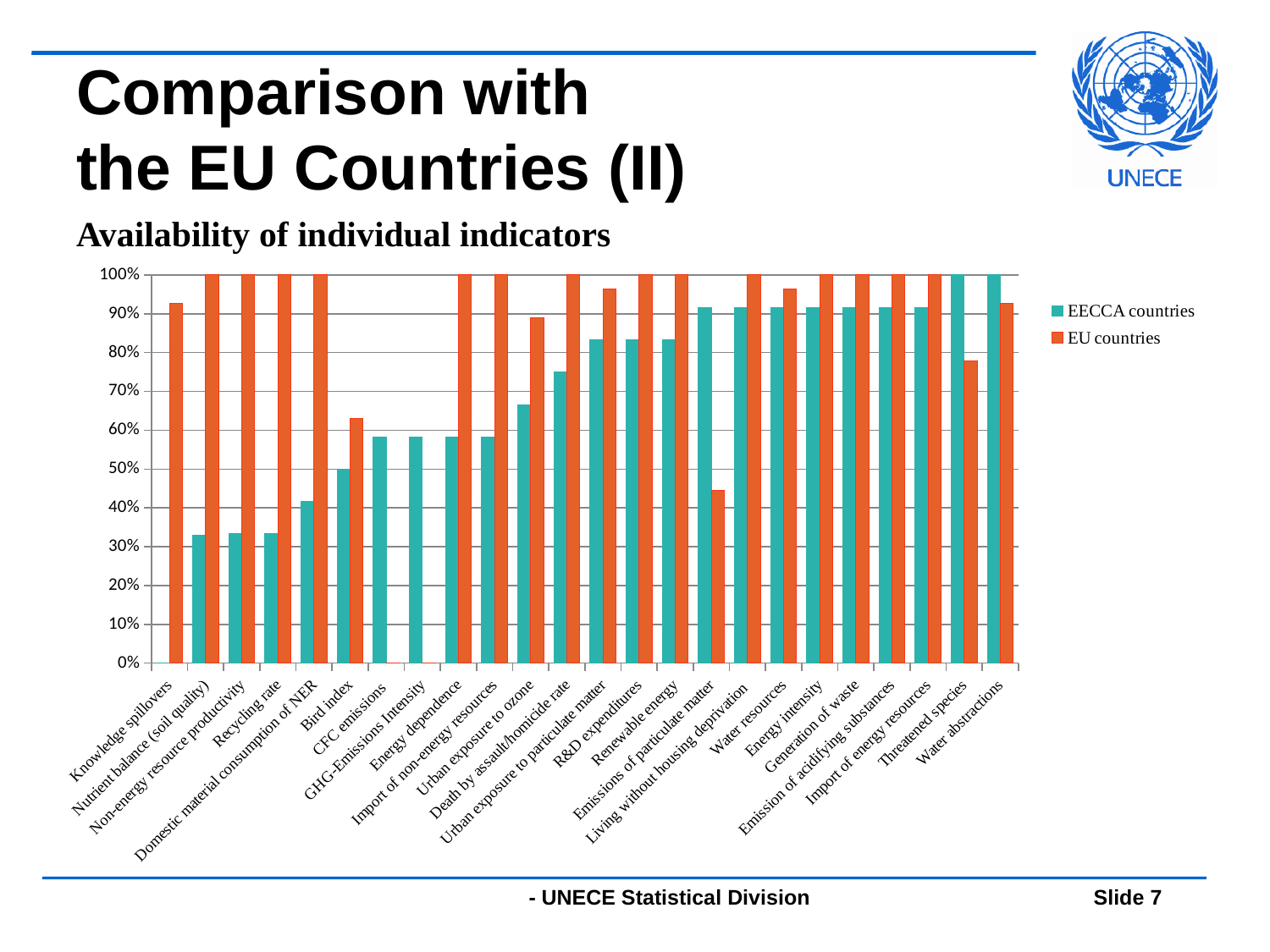
For Threatened species, which series has the larger value, EECCA countries or EU countries? EECCA countries Is the value for EU countries for Emissions of particulate matter greater or less than 50%? less Is the value for EECCA countries for Nutrient balance (soil quality) greater or less than 40%? less How many indicator categories are shown on the x axis? 24 What is the value for EU countries for Nutrient balance (soil quality)? 100% What kind of chart is shown on the slide? bar chart How many series does the legend list? 2 What is the value for EECCA countries for Bird index? 50% What is the value for EECCA countries for Threatened species? 100% For Recycling rate, which series has the larger value, EECCA countries or EU countries? EU countries Which colour represents EECCA countries in the legend? teal